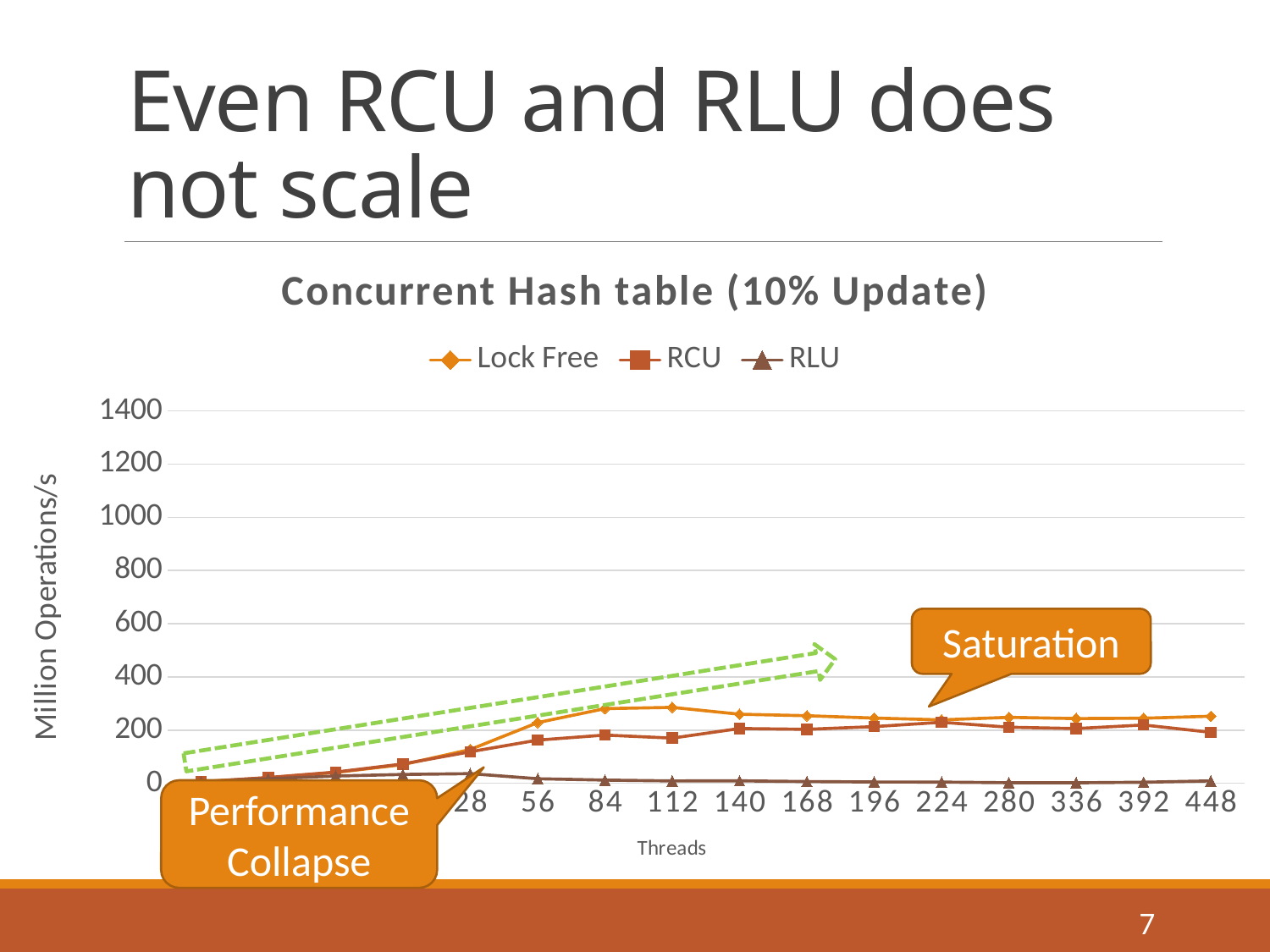
Which series has the lowest value at 448 threads? RLU What kind of chart is shown on the slide? line chart Is the RLU value at 448 threads greater or less than 200? less What is the label on the y axis of the chart? Million Operations/s Is the Lock Free value at 84 threads greater or less than 200? greater Which series has the highest value at 112 threads? Lock Free At 448 threads, which is larger, the Lock Free value or the RLU value? Lock Free Is the Lock Free value at 112 threads greater or less than 400? less How many series does the chart legend list? 3 What is the title of the chart? Concurrent Hash table (10% Update) At 112 threads, which is larger, the Lock Free value or the RCU value? Lock Free